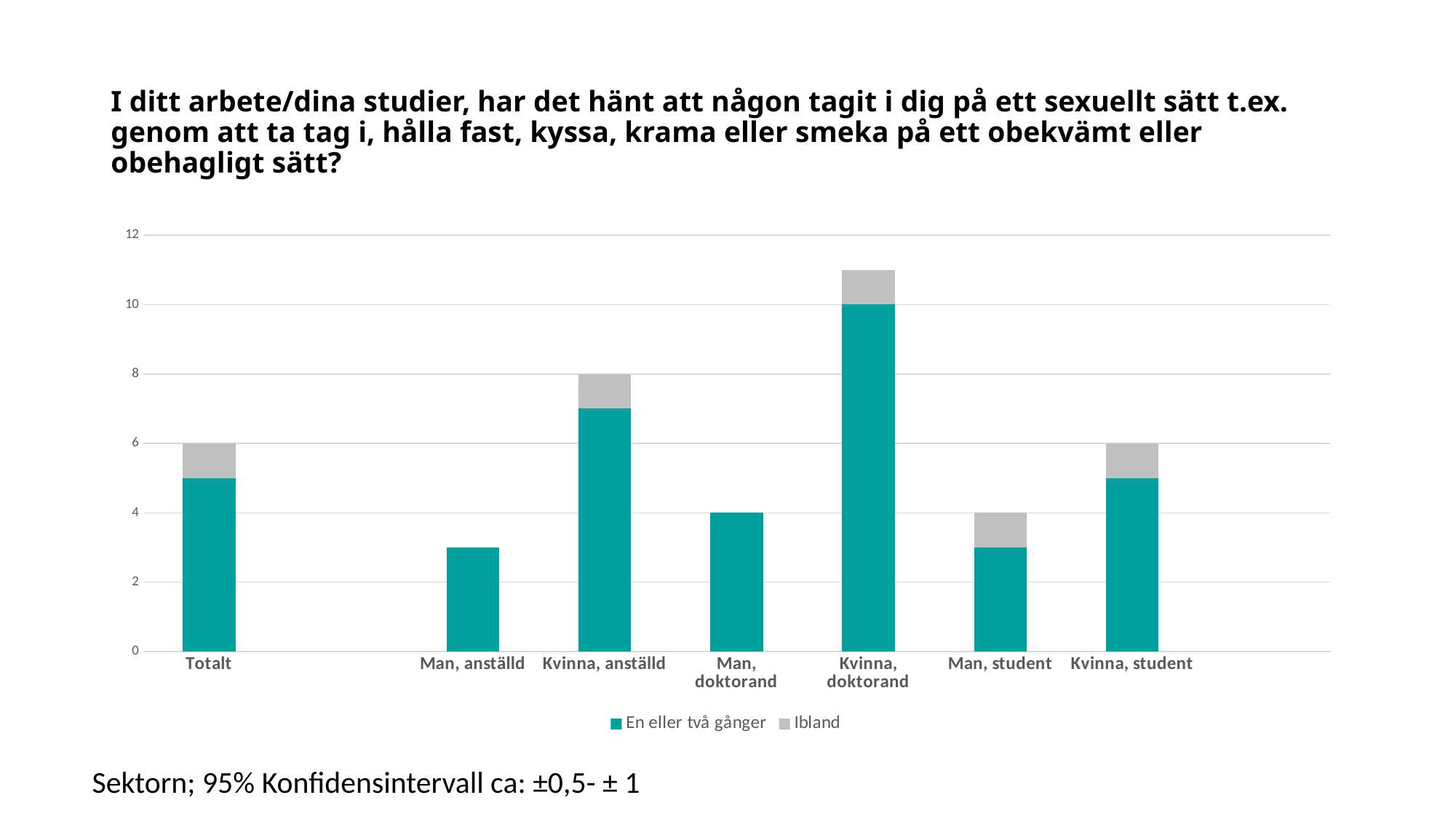
What is the difference between the total stacked bar for Kvinna, anställd and the total for Man, student? 4 Which has the larger total stacked bar, Kvinna, anställd or Kvinna, student? Kvinna, anställd How many series does the legend list? 2 What is the value of 'En eller två gånger' for Kvinna, doktorand? 10 What is the total of the stacked bar for Totalt? 6 How many categories are shown on the x axis? 7 What is the value of 'En eller två gånger' for Man, doktorand? 4 Which category has the highest total stacked bar? Kvinna, doktorand Is the value for Man, anställd greater or less than 4? less What is the total of the stacked bar for Kvinna, anställd? 8 Which category has the lowest total stacked bar? Man, anställd What kind of chart is shown on the slide? Stacked bar chart